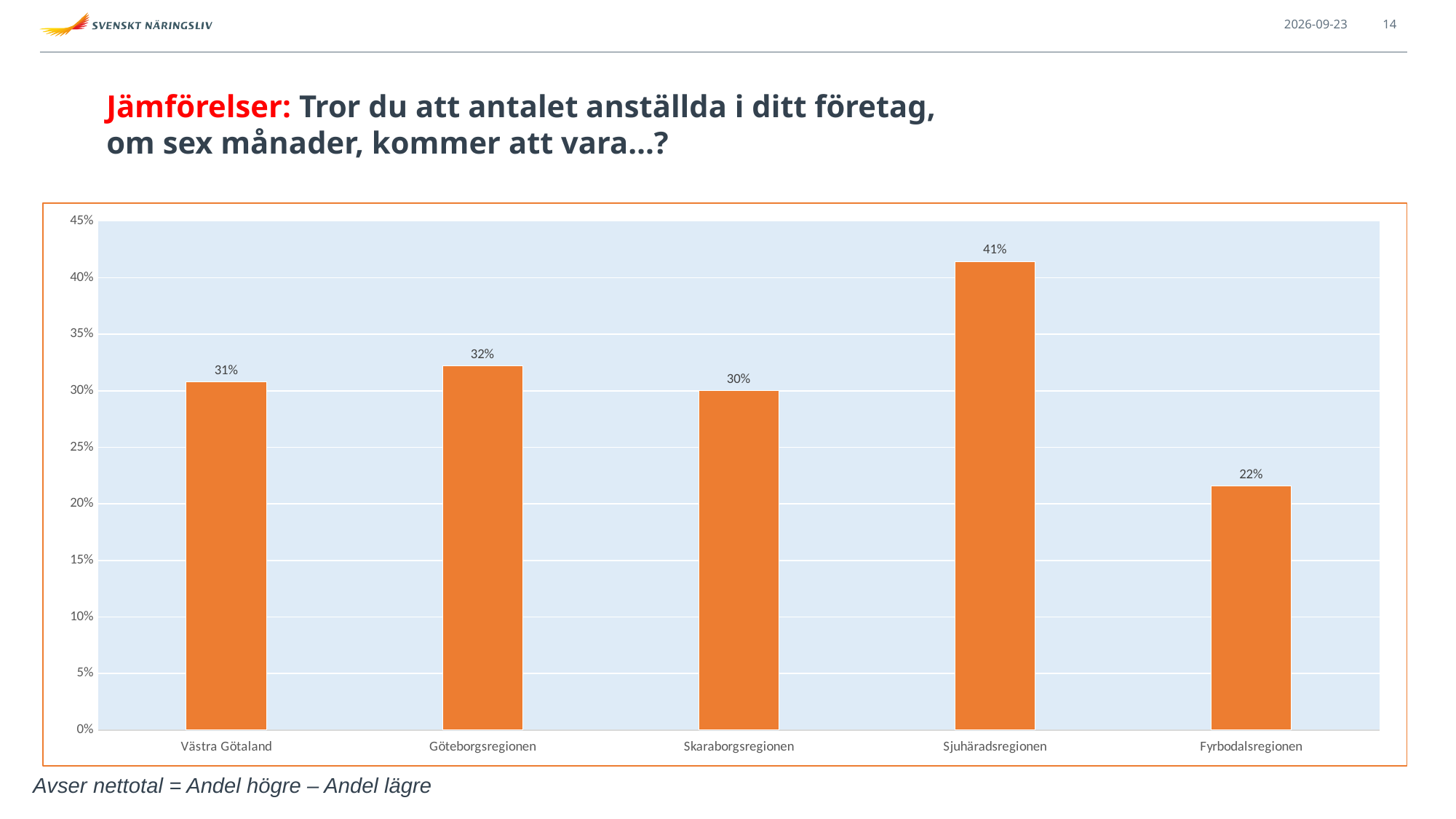
What kind of chart is shown on the slide? bar chart Which region has the highest value? Sjuhäradsregionen Is the value for Fyrbodalsregionen greater or less than 25%? less What is the value for Fyrbodalsregionen? 22% What is the difference between the values for Sjuhäradsregionen and Fyrbodalsregionen? 19% Which is larger, the value for Sjuhäradsregionen or the value for Skaraborgsregionen? Sjuhäradsregionen Which region has the lowest value? Fyrbodalsregionen What is the value for Västra Götaland? 31% How many regions are shown in the chart? 5 What colour are the bars in the chart? orange What is the value for Göteborgsregionen? 32% What is the value for Sjuhäradsregionen? 41%